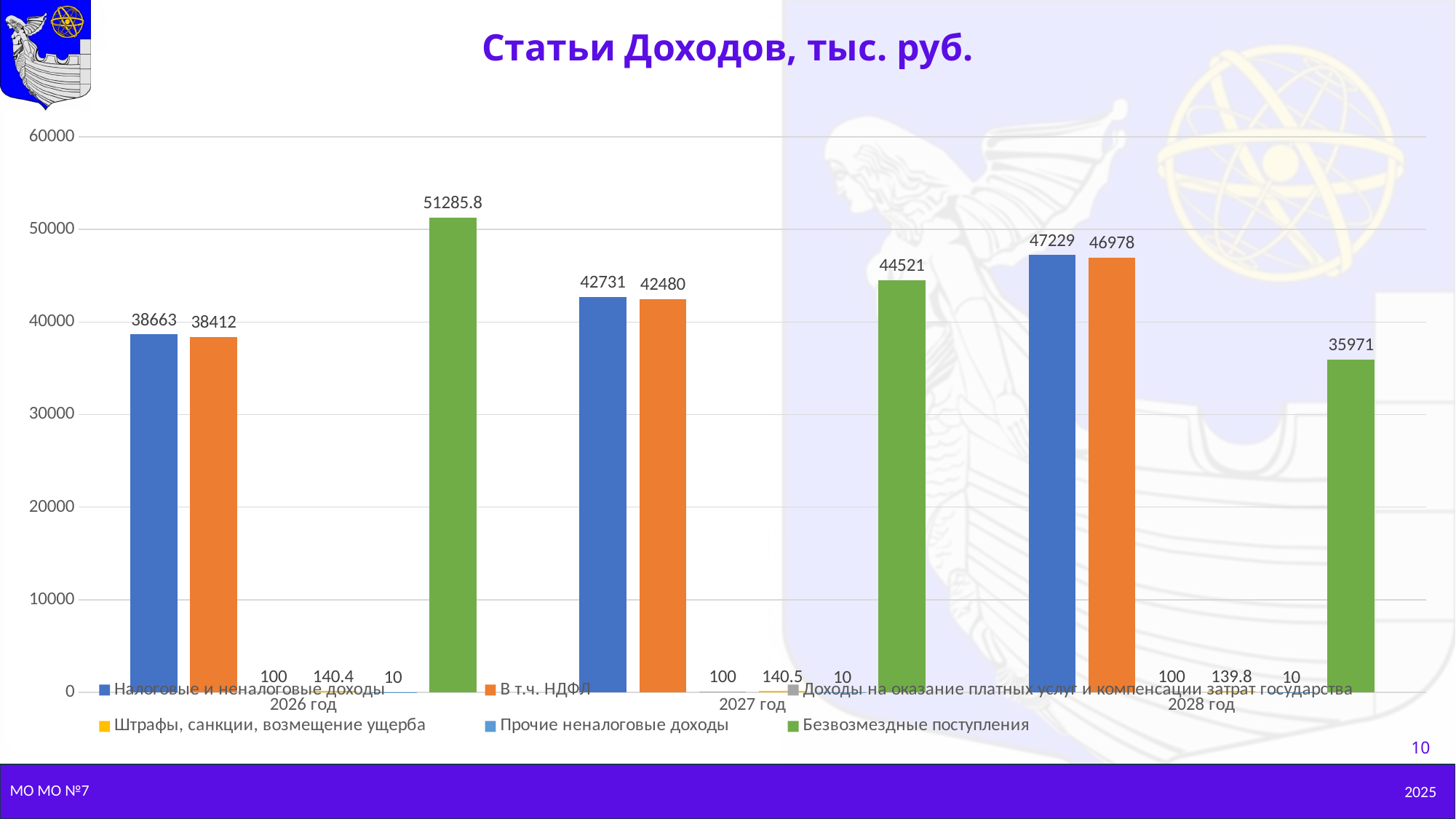
What is the value of Налоговые и неналоговые доходы for 2026 год? 38663 In which year is Налоговые и неналоговые доходы the lowest? 2026 год What kind of chart is shown on the slide? Bar chart What is the value of Безвозмездные поступления for 2026 год? 51285.8 What is the value of Штрафы, санкции, возмещение ущерба for 2027 год? 140.5 In which year is Безвозмездные поступления the highest? 2026 год Which is larger for 2028 год: Налоговые и неналоговые доходы or Безвозмездные поступления? Налоговые и неналоговые доходы What is the difference between Налоговые и неналоговые доходы and В т.ч. НДФЛ for 2027 год? 251 How many years are shown on the x axis? 3 How many series does the legend list? 6 Does Налоговые и неналоговые доходы rise or fall from 2026 год to 2028 год? Rise What is the value of В т.ч. НДФЛ for 2028 год? 46978